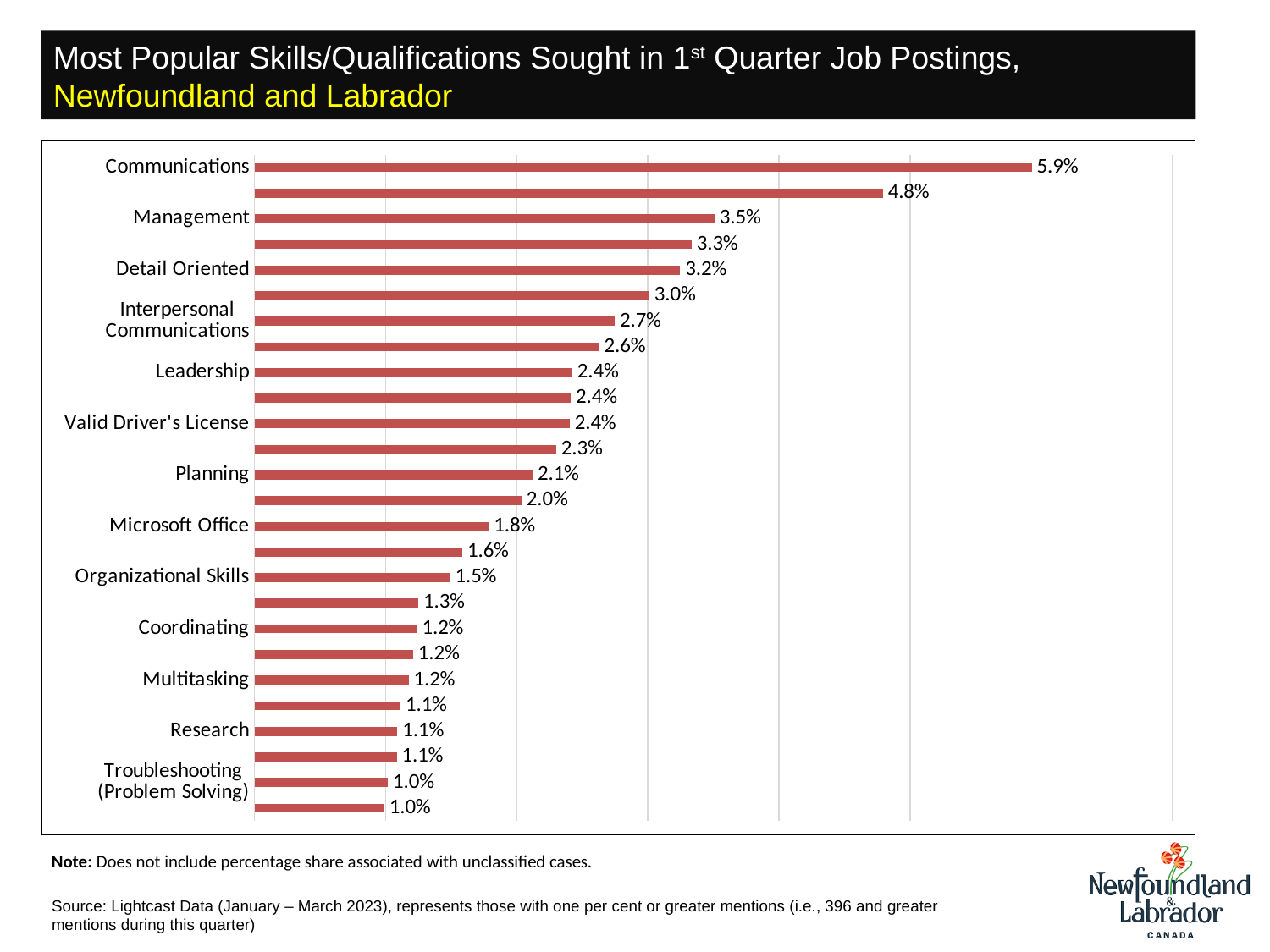
What is the value shown for Management? 3.5% Do the values increase or decrease going from the top bar to the bottom bar? Decrease Which has a larger value, Interpersonal Communications or Organizational Skills? Interpersonal Communications Which has a larger value, Leadership or Research? Leadership What percentage of job postings sought Communications skills? 5.9% What is the difference between the values for Detail Oriented and Planning? 1.1% What is the value shown for Microsoft Office? 1.8% What is the difference between the values for Communications and Management? 2.4% What kind of chart is shown on the slide? Bar chart What is the value shown for Troubleshooting (Problem Solving)? 1.0% How many bars are plotted in the chart? 26 Which skill/qualification has the highest share of job postings? Communications